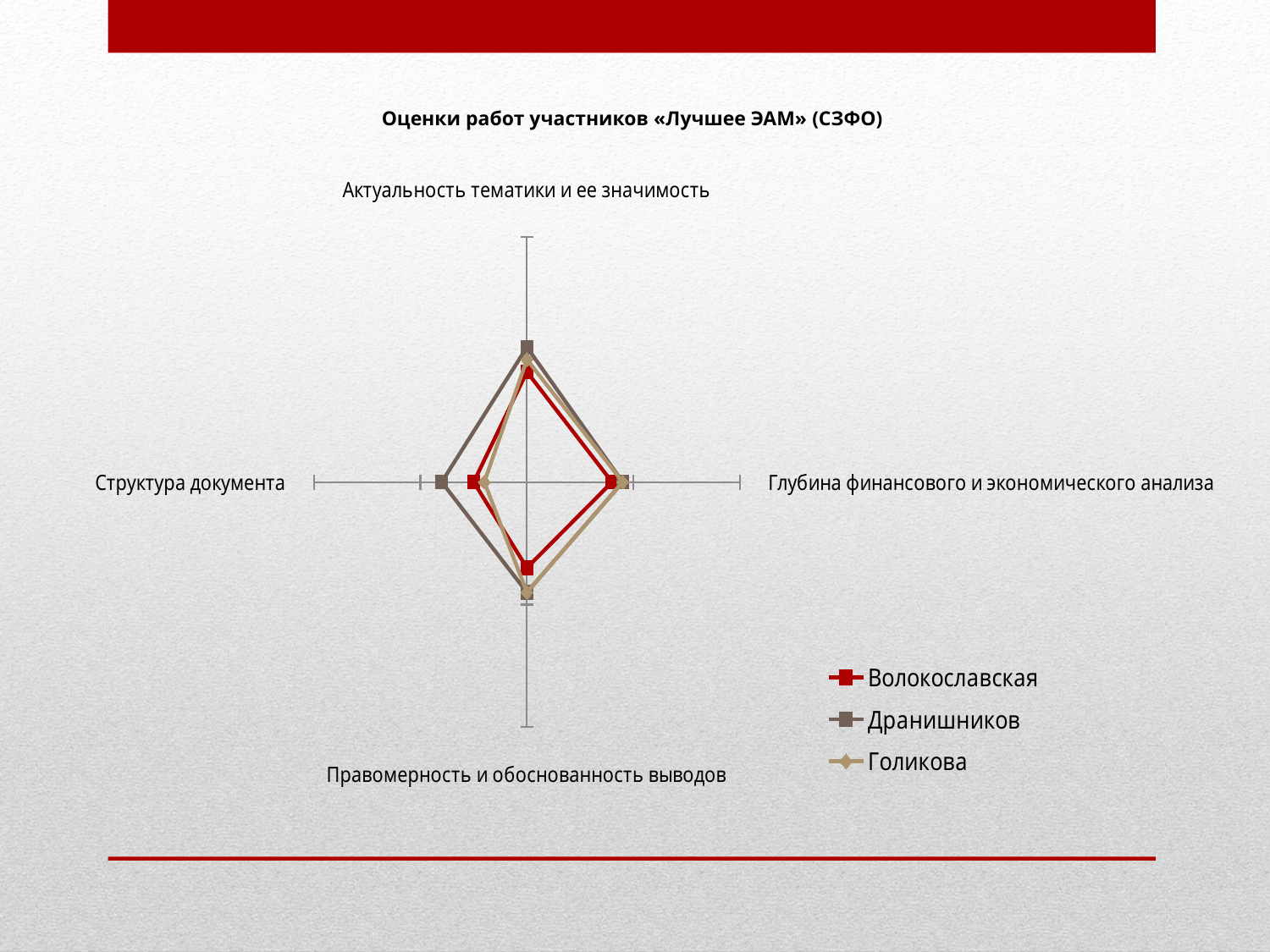
For «Структура документа», who scores higher: Дранишников or Волокославская? Дранишников For «Актуальность тематики и ее значимость», who scores higher: Голикова or Волокославская? Голикова How many criteria (axes) does the radar chart have? 4 Which participant has the highest score for «Актуальность тематики и ее значимость»? Дранишников Which participant has the lowest score for «Актуальность тематики и ее значимость»? Волокославская Which participants are listed in the legend? Волокославская, Дранишников, Голикова How many series does the legend list? 3 Which participant has the lowest score for «Правомерность и обоснованность выводов»? Волокославская What kind of chart is shown on the slide? Radar chart For «Правомерность и обоснованность выводов», who scores higher: Дранишников or Волокославская? Дранишников What is the title of the chart? Оценки работ участников «Лучшее ЭАМ» (СЗФО) Which participant has the highest score for «Структура документа»? Дранишников